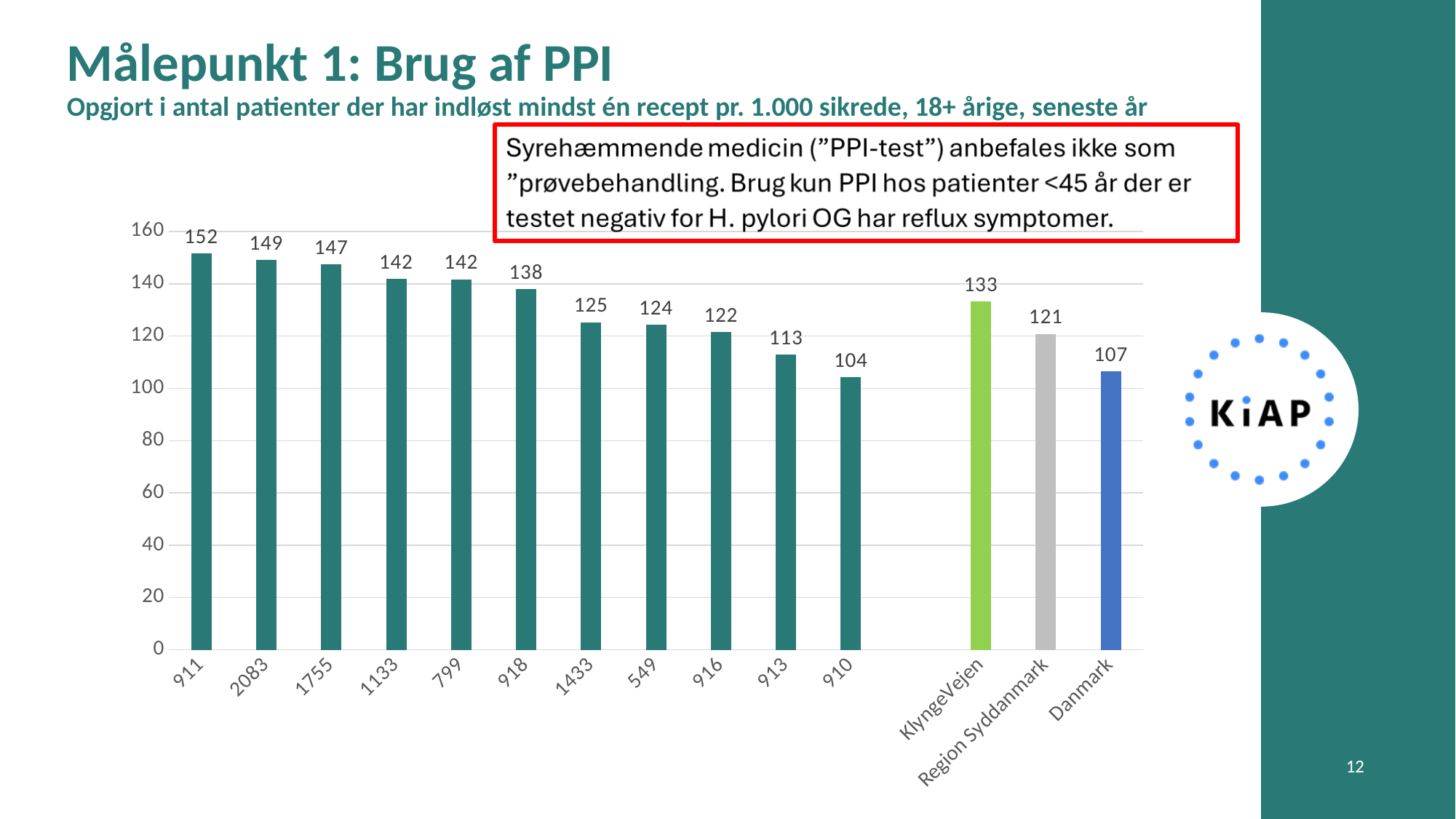
Which is larger, the value for 1433 or the value for 549? 1433 What is the value for the category labelled 911? 152 Which category has the lowest value? 910 What is the value for Region Syddanmark? 121 What is the value for Danmark? 107 Is the value for 918 greater or less than 120? greater What is the value for KlyngeVejen? 133 What kind of chart is shown on the slide? Bar chart What is the difference between the values for 911 and 910? 48 What is the difference between the values for KlyngeVejen and Danmark? 26 Which category has the highest value? 911 How many bars are shown in the chart? 14